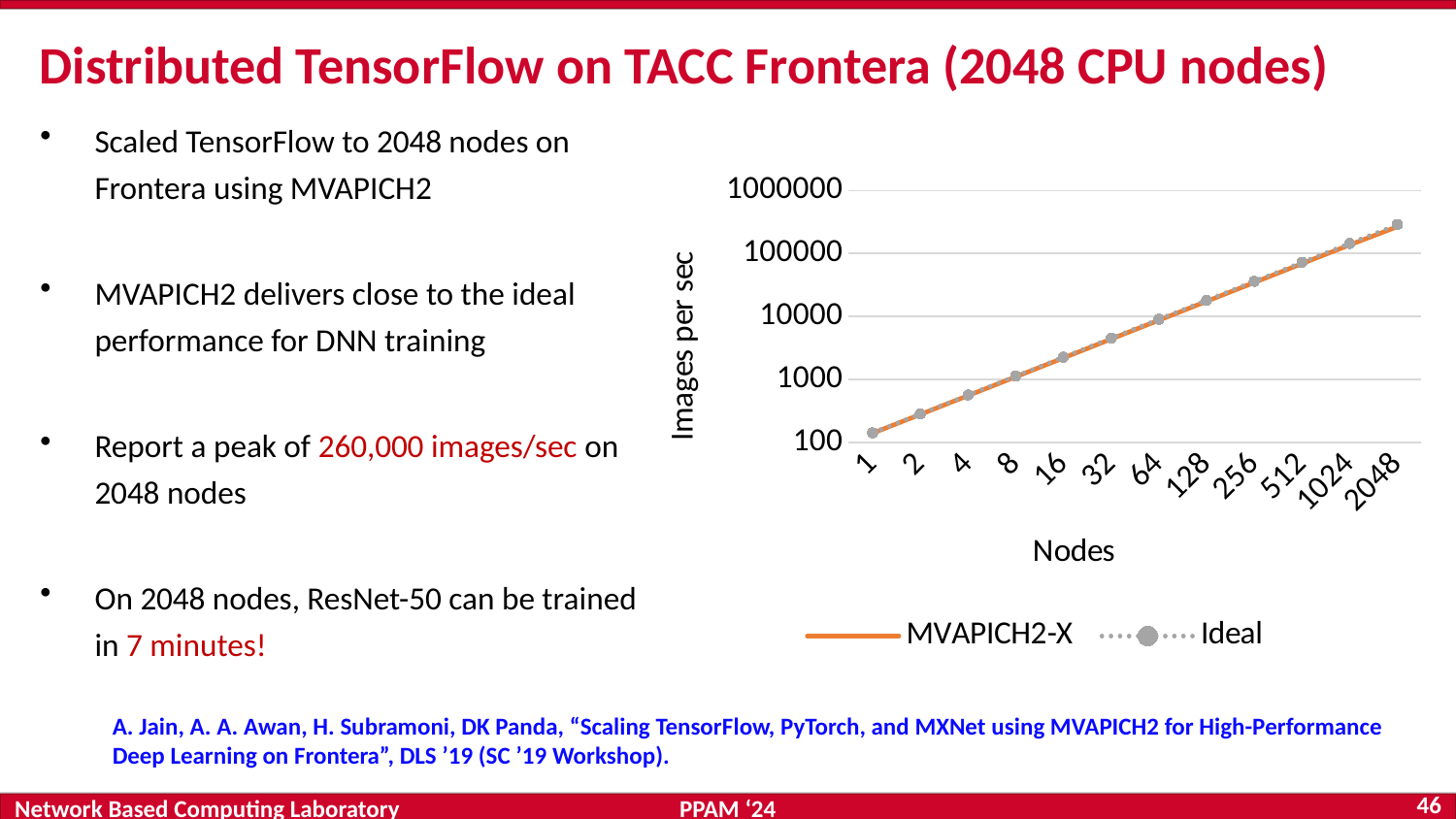
Do the images per sec values rise or fall as the number of nodes increases? rise What is the label of the chart's y axis? Images per sec Is the MVAPICH2-X value at 4 nodes greater or less than 1000 images per sec? less Which is larger, the MVAPICH2-X value at 1024 nodes or at 16 nodes? 1024 nodes Is the MVAPICH2-X value at 32 nodes greater or less than 10000 images per sec? less Is the MVAPICH2-X value at 2048 nodes greater or less than 100000 images per sec? greater What are the two series named in the chart's legend? MVAPICH2-X and Ideal How many series does the chart's legend list? 2 At which node count is the MVAPICH2-X images per sec value highest? 2048 What kind of chart is shown on the slide? line chart How many node counts are plotted along the x axis of the chart? 12 At which node count is the MVAPICH2-X images per sec value lowest? 1